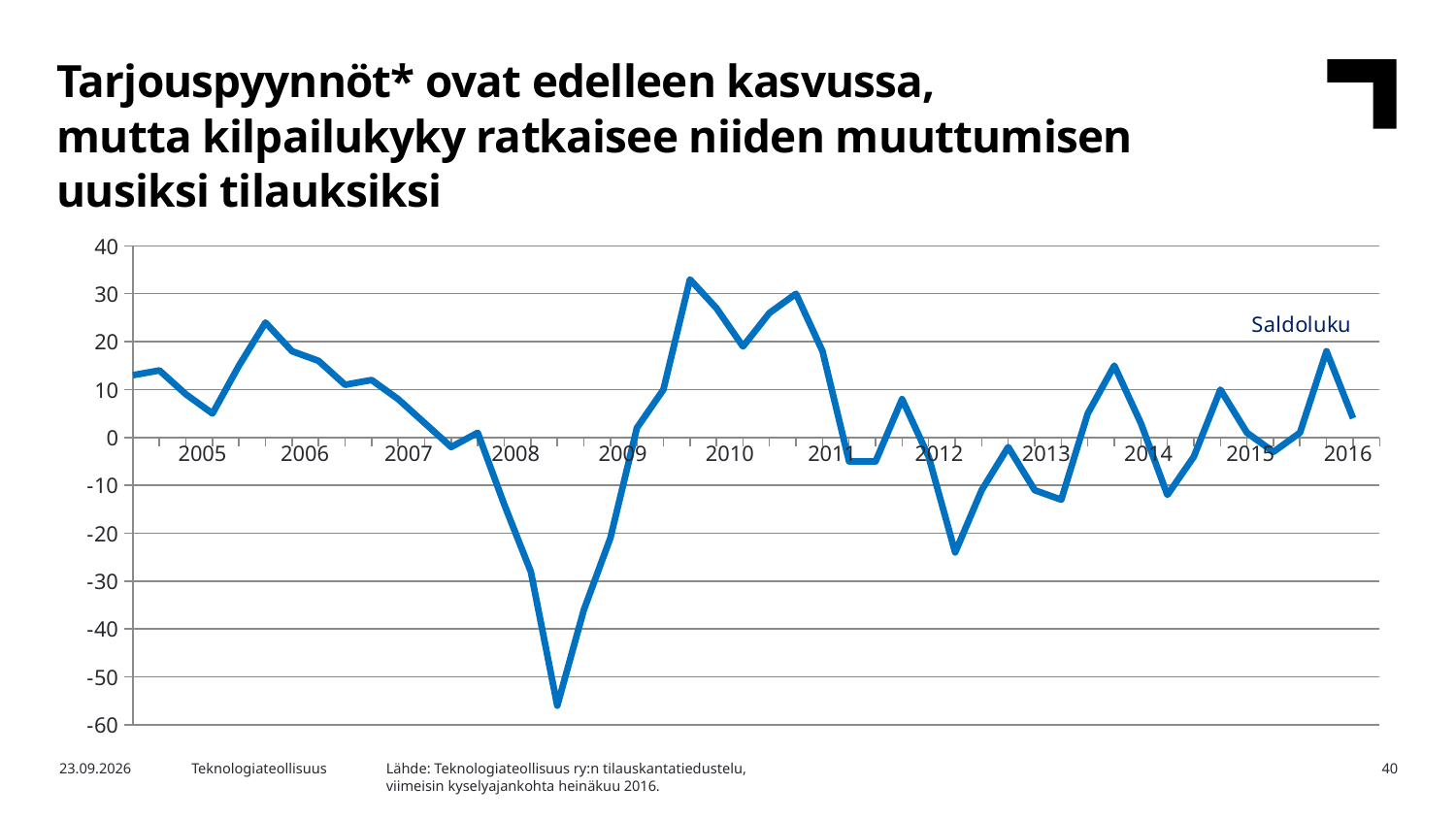
What is the name of the series plotted on the chart? Saldoluku Is the lowest point around 2012 greater or less than -20? less Which is larger: the value at the 2008 low or the value at the 2012 low? 2012 low Is the value at the start of the series (2005) greater or less than 0? greater Is the highest point of the line greater or less than 20? greater How many year labels are shown on the x axis? 12 How many data series does the chart show? 1 What kind of chart is shown on the slide? line chart What is the highest value shown on the y axis? 40 Does the line rise or fall between its 2008 low and its peak around 2009-2010? rise